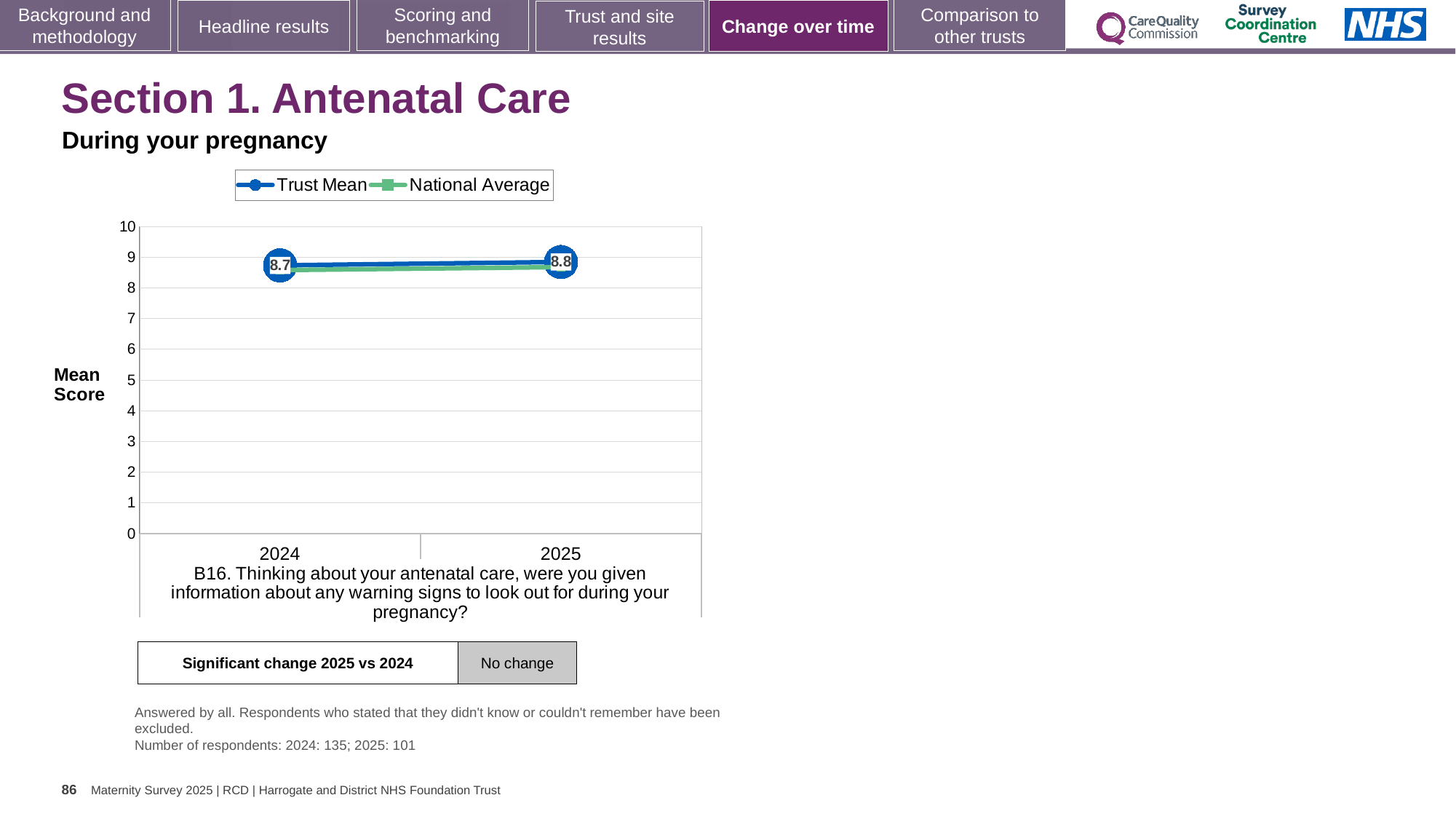
How many series does the chart legend list? 2 In which year is the Trust Mean score lower? 2024 Is the National Average value for 2024 greater or less than 8? greater What kind of chart is shown on the slide? line chart Is the Trust Mean score for 2025 larger or smaller than the Trust Mean score for 2024? larger How many years are shown on the x axis of the chart? 2 What is the Trust Mean score for 2025? 8.8 What is the Trust Mean score for 2024? 8.7 What is the difference between the Trust Mean scores for 2025 and 2024? 0.1 What are the two series named in the chart legend? Trust Mean and National Average Does the Trust Mean rise or fall from 2024 to 2025? rise In which year is the Trust Mean score higher? 2025